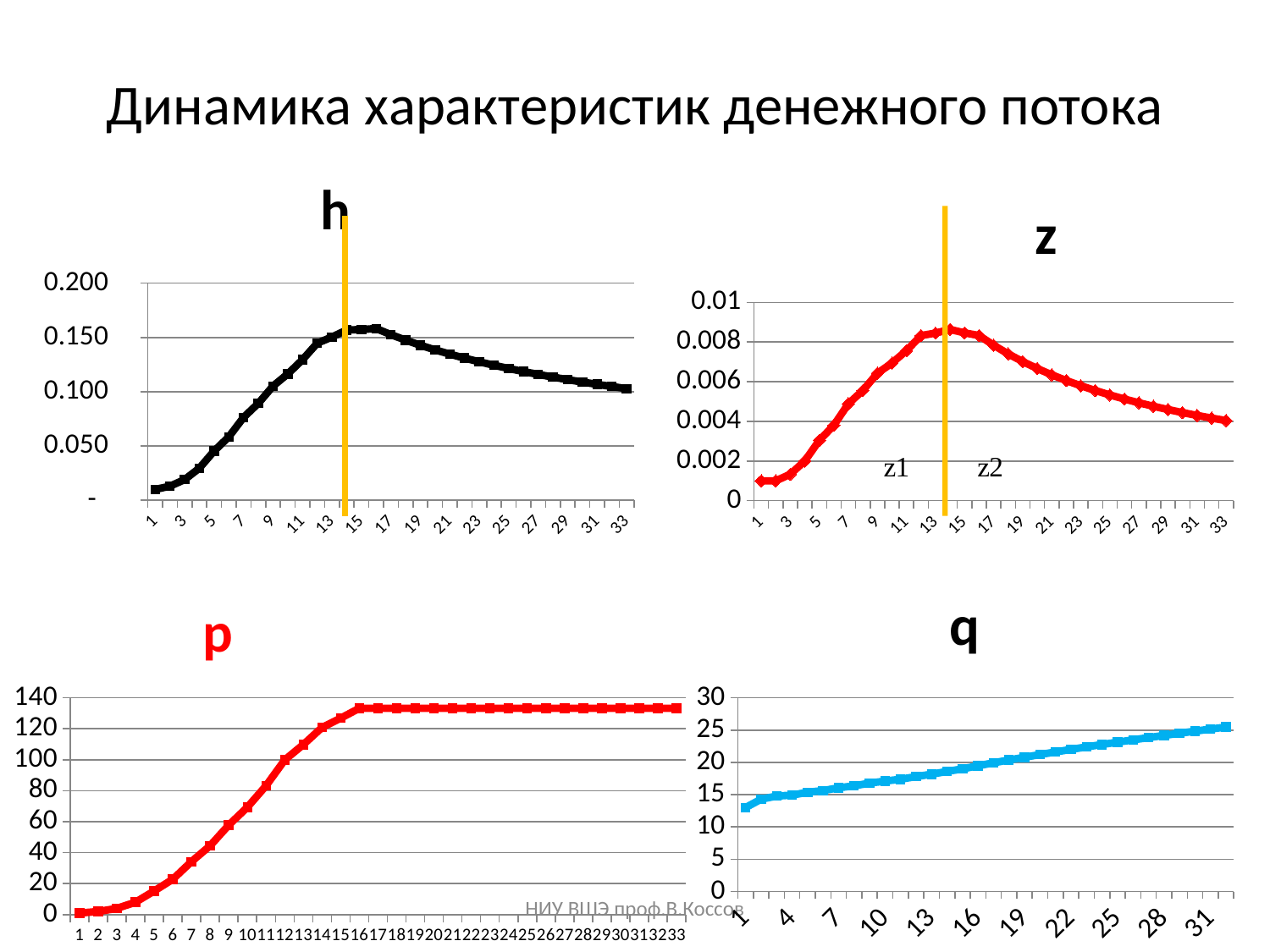
In the chart titled p, is the value at x = 33 greater or less than 120? greater In the chart titled q, is the value at x = 1 greater or less than 15? less In the chart titled h, is the value at x = 1 greater or less than 0.050? less In the chart titled q, do the values rise or fall along the x axis? rise In the chart titled h, do the values rise or fall after the orange vertical line? fall What colour is the line in the chart titled q? blue How many data points are plotted in the chart titled p (x axis 1 to 33)? 33 In the chart titled p, how do the values behave along the x axis? rise, then level off What kind of chart is the chart titled h? line chart